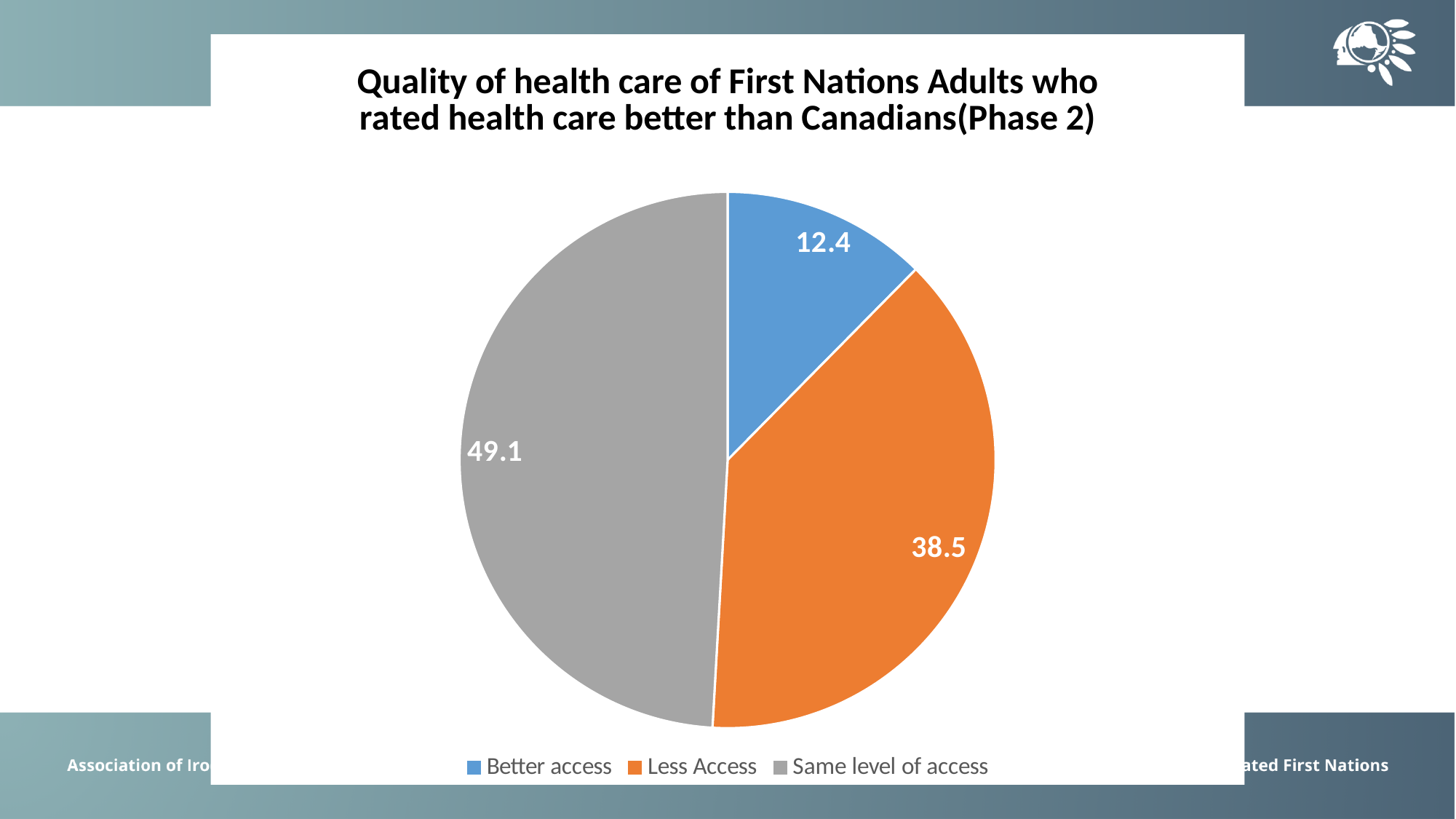
What is the difference between the values for Less Access and Better access? 26.1 What is the value for Less Access? 38.5 What colour is the Less Access slice? orange What is the difference between the values for Same level of access and Less Access? 10.6 What kind of chart is shown on the slide? pie chart How many entries does the legend list? 3 Which category has the largest slice? Same level of access What is the value for Better access? 12.4 Which category has the smallest slice? Better access What is the value for Same level of access? 49.1 Which is larger, Less Access or Better access? Less Access How many slices does the pie chart have? 3